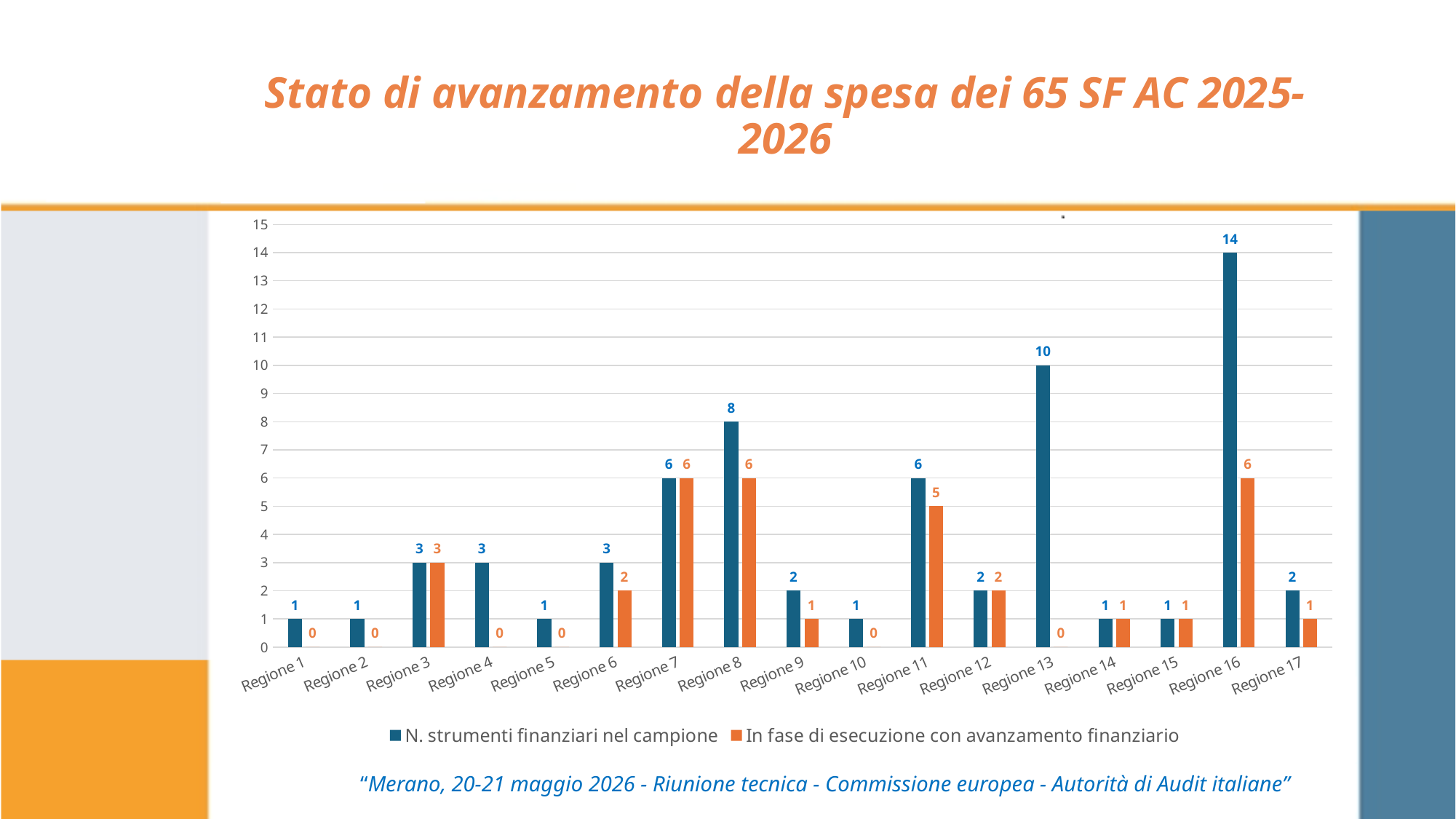
Which is larger: 'N. strumenti finanziari nel campione' for Regione 7 or for Regione 8? Regione 8 Which region has the highest value for 'N. strumenti finanziari nel campione'? Regione 16 How many regions are shown on the x axis? 17 What is the difference between 'N. strumenti finanziari nel campione' and 'In fase di esecuzione con avanzamento finanziario' for Regione 16? 8 What colour are the bars for 'In fase di esecuzione con avanzamento finanziario'? Orange What kind of chart is shown on the slide? Bar chart What is the value of 'N. strumenti finanziari nel campione' for Regione 16? 14 What is the difference between 'N. strumenti finanziari nel campione' for Regione 13 and Regione 8? 2 What is the value of 'In fase di esecuzione con avanzamento finanziario' for Regione 13? 0 Is the value of 'N. strumenti finanziari nel campione' for Regione 13 greater or less than 5? greater How many series does the legend list? 2 What is the value of 'In fase di esecuzione con avanzamento finanziario' for Regione 11? 5